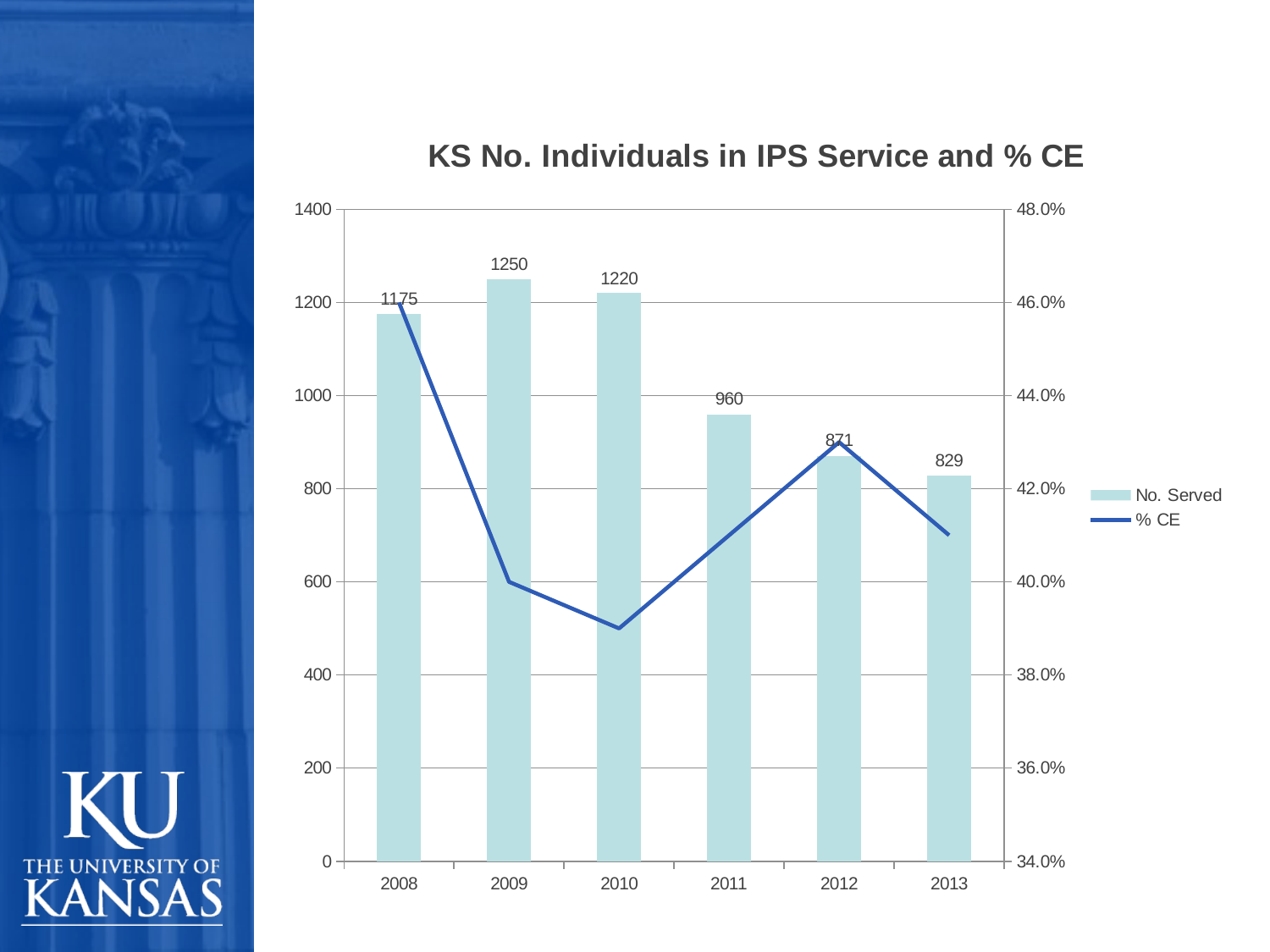
Which year has the highest No. Served? 2009 What is the value of No. Served for 2013? 829 Which year has a larger No. Served, 2010 or 2011? 2010 What is the difference in No. Served between 2009 and 2013? 421 Which year has the lowest No. Served? 2013 Is the % CE value for 2012 greater or less than 42.0%? greater How many series does the legend list? 2 How many years are shown on the x axis? 6 Is the % CE value for 2010 greater or less than 40.0%? less What is the title of the chart? KS No. Individuals in IPS Service and % CE What is the value of No. Served for 2011? 960 What is the value of No. Served for 2009? 1250